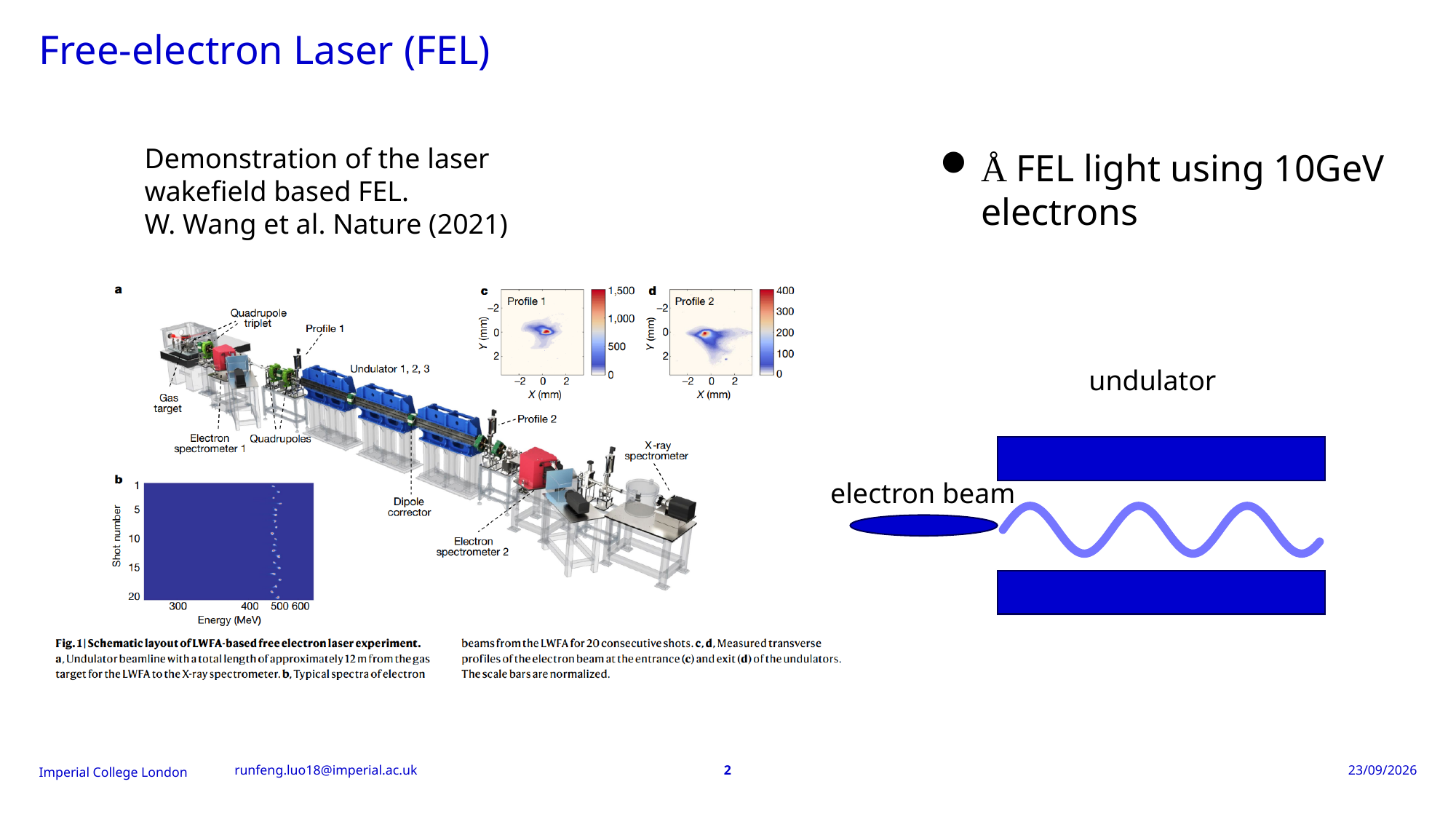
What is the y-axis label of panels c and d in the figure? Y (mm) In panel b of the figure, what is the lowest energy tick shown on the x axis? 300 In panel b of the figure, what is the highest shot number shown on the y axis? 20 What is the x-axis label of panel b in the figure? Energy (MeV) Which profile panel has the higher colour-scale maximum, Profile 1 or Profile 2? Profile 1 In panel d (Profile 2) of the figure, what is the maximum value shown on the colour scale? 400 How many transverse profile panels (heatmaps) are shown in the figure? 2 In panel c (Profile 1) of the figure, what is the maximum value shown on the colour scale? 1,500 In panel b of the figure, what is the highest energy tick shown on the x axis? 600